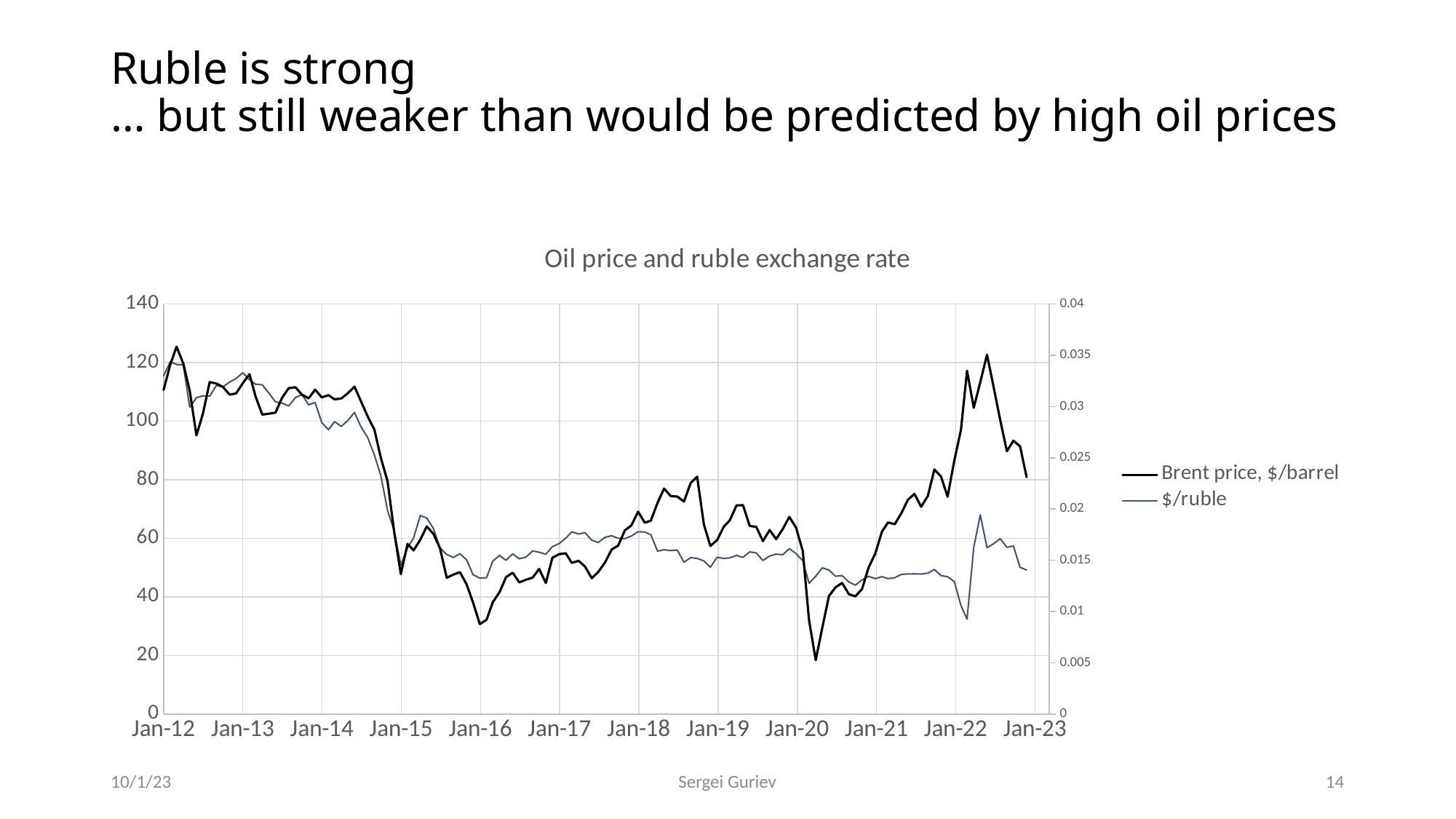
Is the Brent price at Jan-23 greater or less than 60? greater Is the Brent price at Jan-16 greater or less than 40? less What is the title of the chart? Oil price and ruble exchange rate Is the $/ruble value at Jan-23 greater or less than 0.02? less How many year labels are shown on the x axis? 12 What kind of chart is shown on the slide? Line chart Does the Brent price rise or fall between Jan-14 and Jan-16? fall In which year does the Brent price reach its lowest point? 2020 How many series does the legend list? 2 Which series is drawn with the thicker black line? Brent price, $/barrel